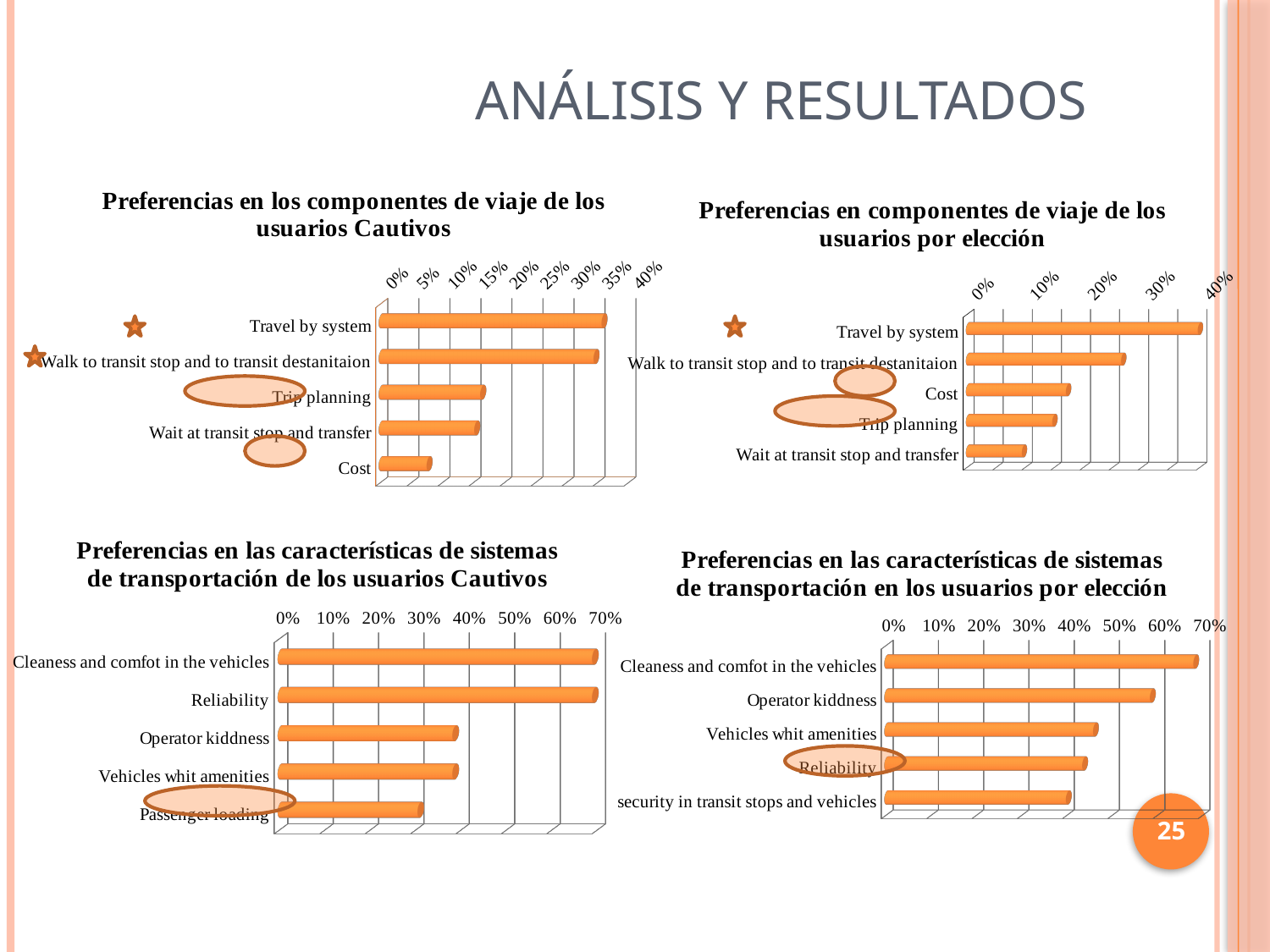
In the chart 'Preferencias en las características de sistemas de transportación en los usuarios por elección', which category has the highest value? Cleaness and comfot in the vehicles In the chart 'Preferencias en los componentes de viaje de los usuarios Cautivos', is the value for Trip planning greater or less than 20%? less In the chart 'Preferencias en las características de sistemas de transportación de los usuarios Cautivos', which category has the lowest value? Passenger loading In the chart 'Preferencias en componentes de viaje de los usuarios por elección', which category has the lowest value? Wait at transit stop and transfer In the chart 'Preferencias en las características de sistemas de transportación de los usuarios Cautivos', is the value for Passenger loading greater or less than 40%? less In the chart 'Preferencias en componentes de viaje de los usuarios por elección', which category has the highest value? Travel by system In the chart 'Preferencias en las características de sistemas de transportación en los usuarios por elección', which is larger: Operator kiddness or Vehicles whit amenities? Operator kiddness In the chart 'Preferencias en componentes de viaje de los usuarios por elección', is the value for Walk to transit stop and to transit destanitaion greater or less than 20%? greater What kind of chart is 'Preferencias en los componentes de viaje de los usuarios Cautivos'? Bar chart How many categories are shown in the chart 'Preferencias en los componentes de viaje de los usuarios Cautivos'? 5 In the chart 'Preferencias en componentes de viaje de los usuarios por elección', which is larger: Walk to transit stop and to transit destanitaion or Cost? Walk to transit stop and to transit destanitaion In the chart 'Preferencias en los componentes de viaje de los usuarios Cautivos', which category has the lowest value? Cost